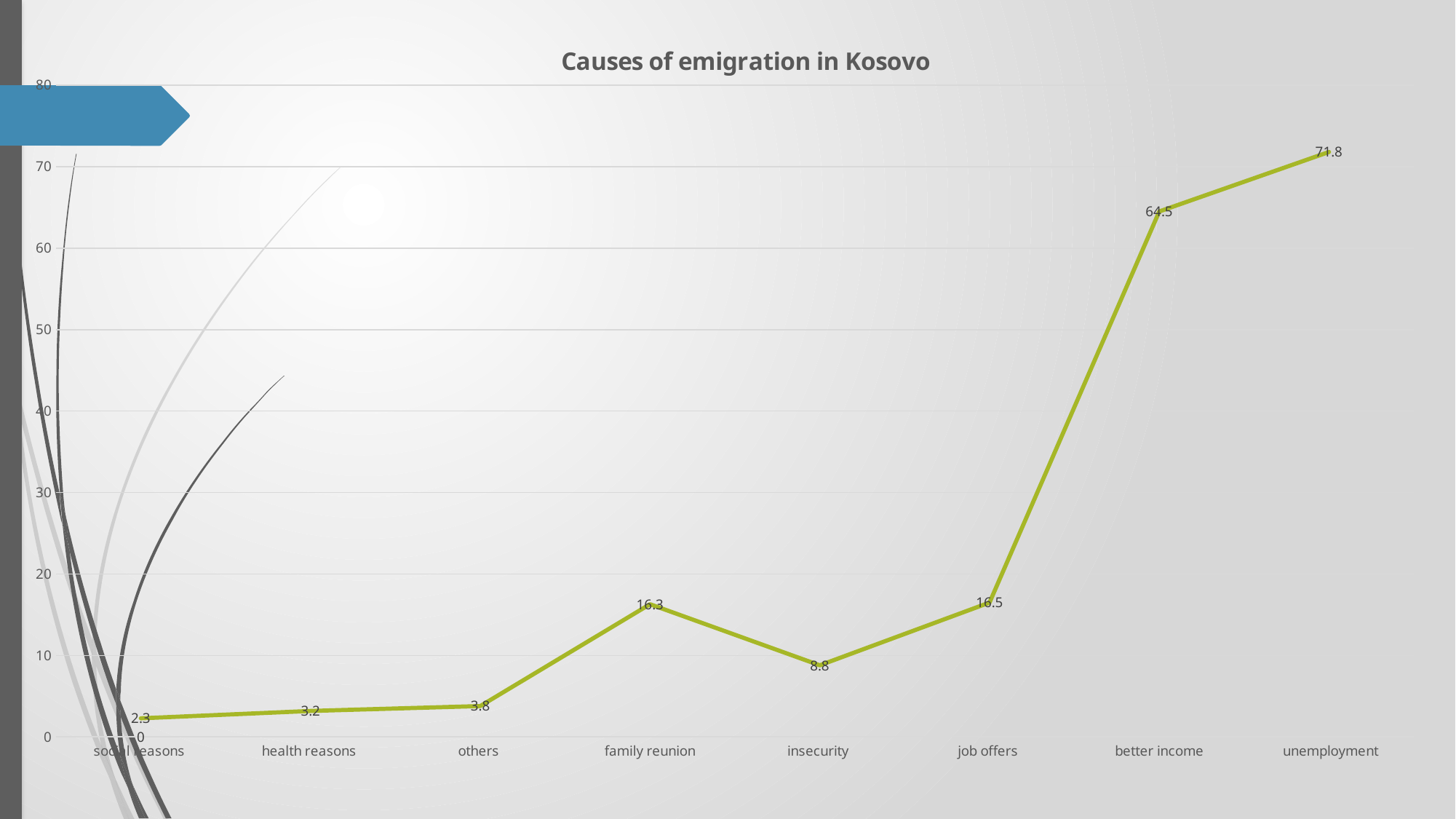
What is the difference between the values for unemployment and better income? 7.3 Is the value for better income greater or less than 60? greater What is the title of the chart? Causes of emigration in Kosovo What is the difference between the values for job offers and insecurity? 7.7 What is the value for family reunion? 16.3 What type of chart is shown on the slide? line chart What is the value for unemployment? 71.8 What is the value for better income? 64.5 Which cause has the highest value? unemployment What is the value for insecurity? 8.8 Which is larger, the value for family reunion or the value for insecurity? family reunion How many causes are plotted along the x axis? 8